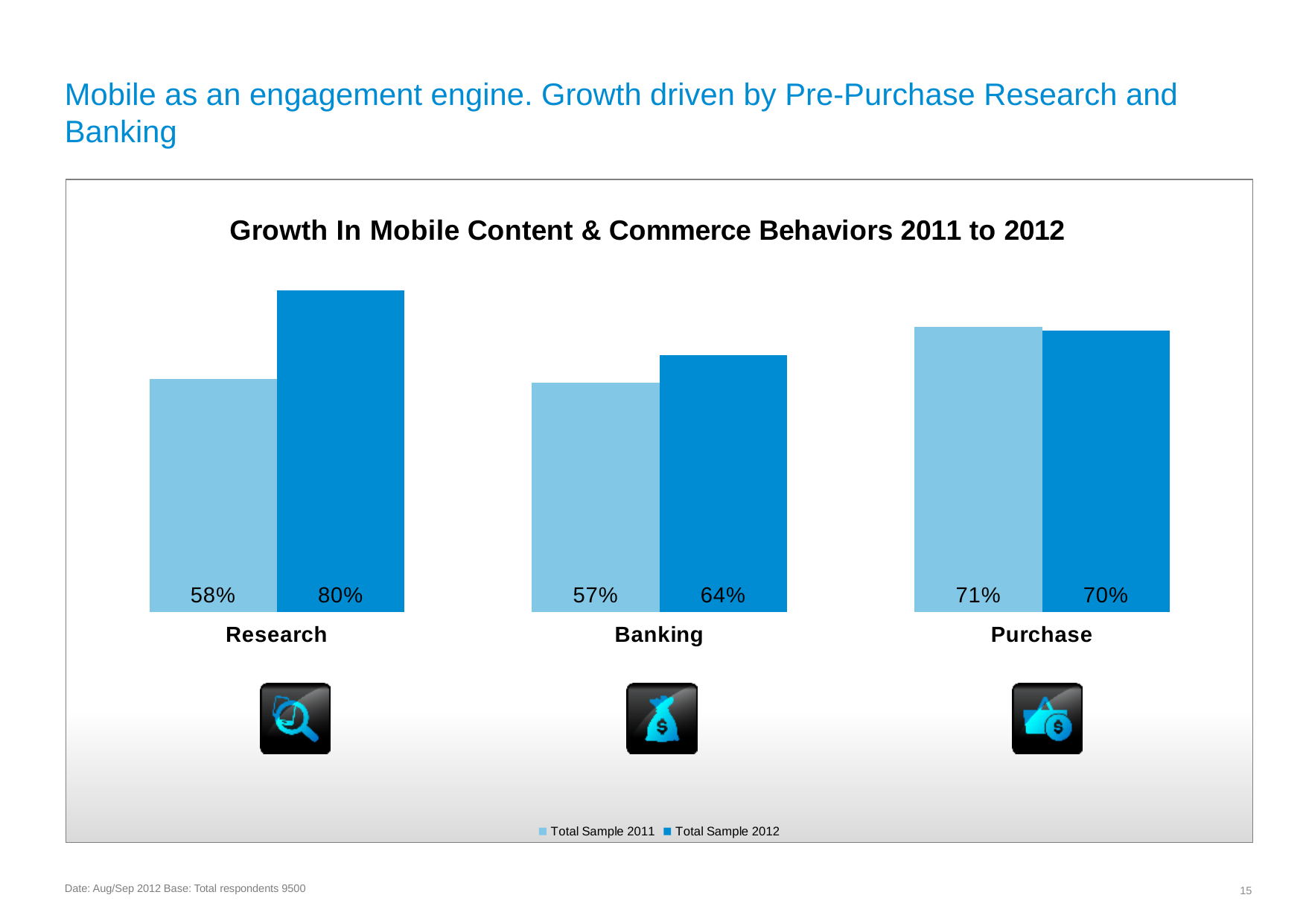
What is the value for Banking in the Total Sample 2011 series? 57% What is the difference between the Total Sample 2012 and Total Sample 2011 values for Banking? 7% What kind of chart is shown on the slide? Bar chart Which category has the lowest value in the Total Sample 2011 series? Banking What is the value for Research in the Total Sample 2012 series? 80% How many series does the legend list? 2 What is the title of the chart? Growth In Mobile Content & Commerce Behaviors 2011 to 2012 What is the value for Purchase in the Total Sample 2012 series? 70% Which is larger for Purchase: the Total Sample 2011 value or the Total Sample 2012 value? Total Sample 2011 Which category has the highest value in the Total Sample 2012 series? Research How many categories are shown on the x axis? 3 What is the difference between the Total Sample 2012 and Total Sample 2011 values for Research? 22%